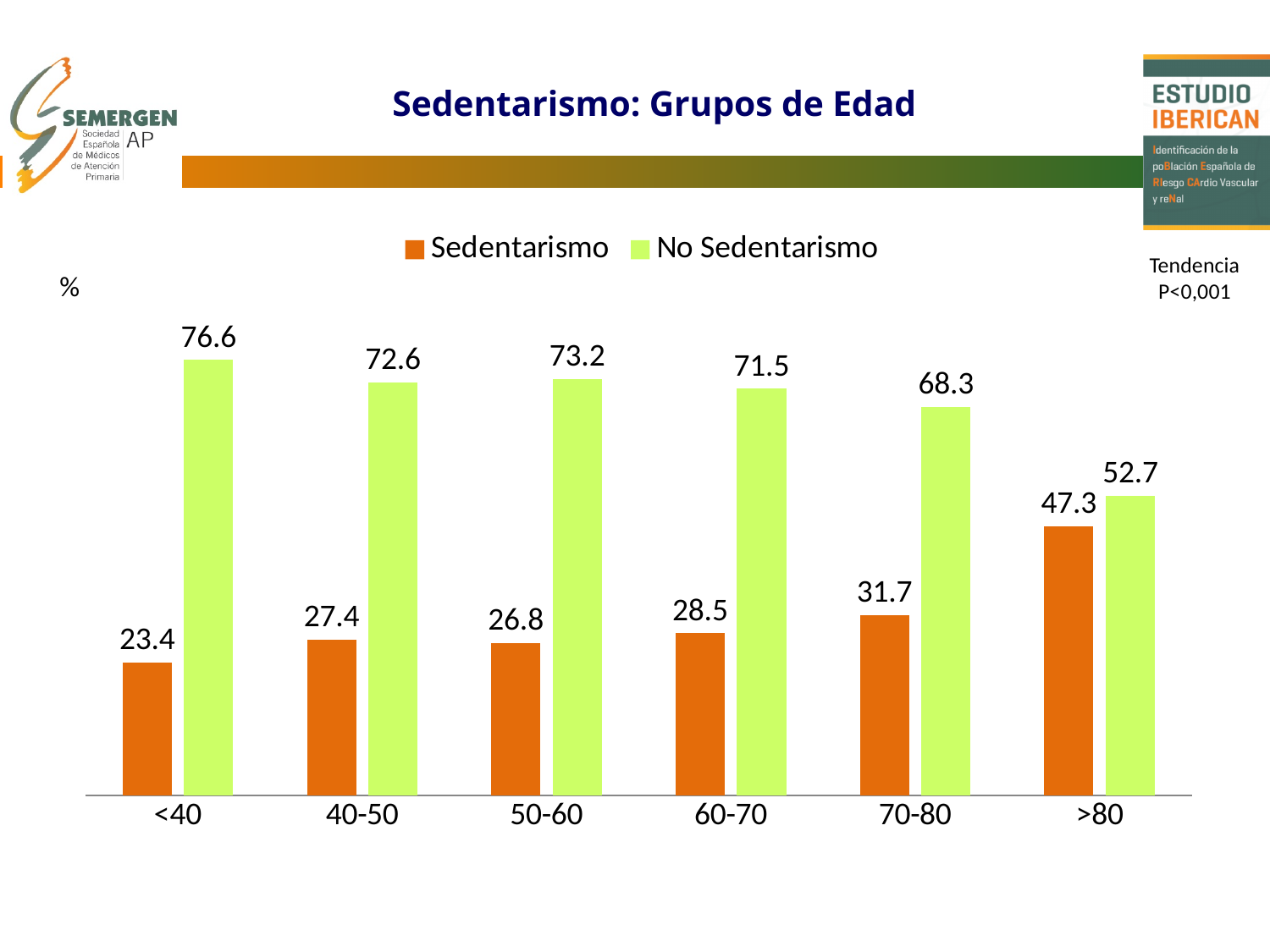
Which age group has the lowest No Sedentarismo value? >80 What is the Sedentarismo value for the <40 age group? 23.4 How many age groups are shown on the x axis? 6 What is the difference between the No Sedentarismo and Sedentarismo values for the 70-80 age group? 36.6 How many series does the legend list? 2 Which is larger: the Sedentarismo value for 40-50 or for 50-60? 40-50 What is the No Sedentarismo value for the 60-70 age group? 71.5 What is the title of the chart? Sedentarismo: Grupos de Edad What kind of chart is shown on the slide? bar chart Which age group has the highest Sedentarismo value? >80 Which age group has the lowest Sedentarismo value? <40 What is the Sedentarismo value for the >80 age group? 47.3